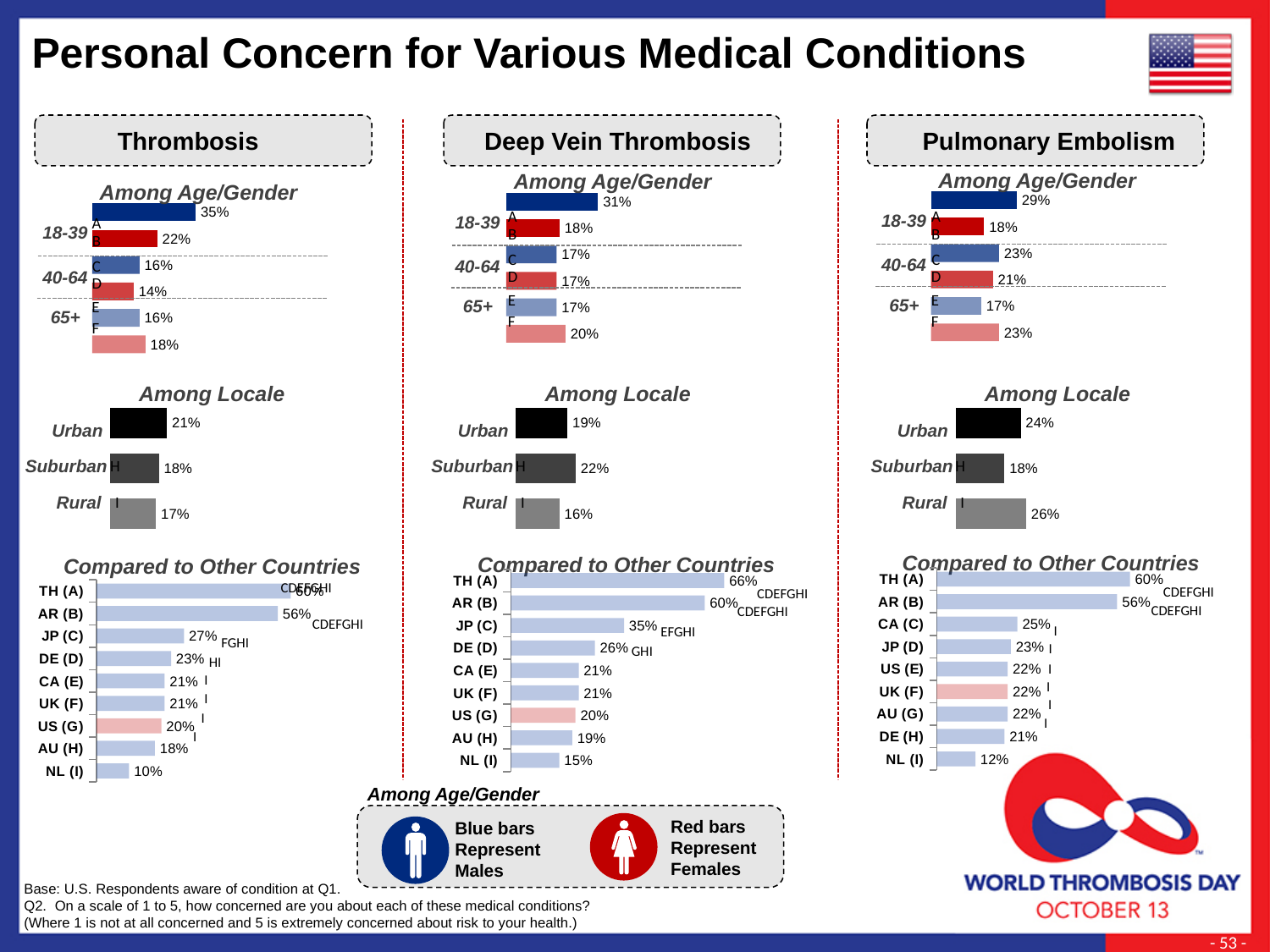
In the Thrombosis 'Among Age/Gender' chart, which is larger, the 18-39 male bar (A) or the 18-39 female bar (B)? A (male) In the Pulmonary Embolism 'Compared to Other Countries' chart, which country has the lowest value? NL (I) In the Deep Vein Thrombosis 'Compared to Other Countries' chart, which country has the highest value? TH (A) In the Deep Vein Thrombosis 'Compared to Other Countries' chart, what is the difference between TH (A) and AR (B)? 6% In the Pulmonary Embolism 'Among Age/Gender' chart, what is the value for the 18-39 male bar (A)? 29% According to the legend at the bottom of the slide, what do the red bars in the 'Among Age/Gender' charts represent? Females What type of chart is the Thrombosis 'Among Locale' chart? Bar chart In the Thrombosis 'Compared to Other Countries' chart, what is the value for US (G)? 20% In the Deep Vein Thrombosis 'Among Locale' chart, what is the value for Suburban? 22% In the Pulmonary Embolism 'Among Locale' chart, which is larger, Urban or Rural? Rural How many countries are listed in the Thrombosis 'Compared to Other Countries' chart? 9 In the Thrombosis 'Among Locale' chart, what is the difference between the Urban and Rural values? 4%